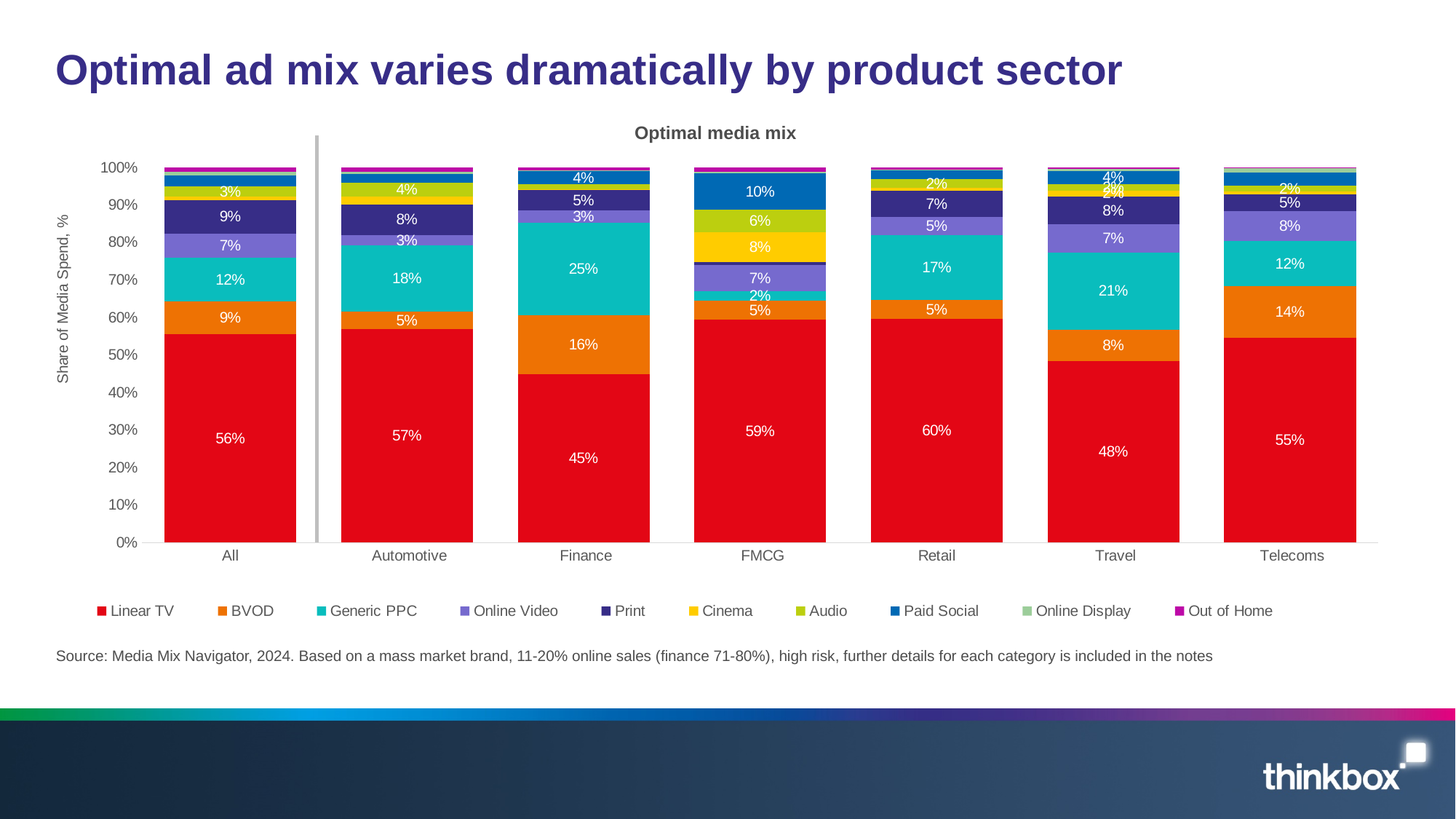
What is the Generic PPC share for the Travel sector? 21% What is the Linear TV share of media spend for the Finance sector? 45% How many series does the legend list? 10 What is the Paid Social share for FMCG? 10% What kind of chart is shown on the slide? Stacked bar chart What is the BVOD share for Telecoms? 14% How many sectors (categories) are shown on the x axis? 7 How many percentage points higher is the Generic PPC share for Finance than for All? 13 percentage points Which sector has the highest Linear TV share? Retail Which sector has the lowest Linear TV share? Finance Which has a larger BVOD share, Finance or Automotive? Finance